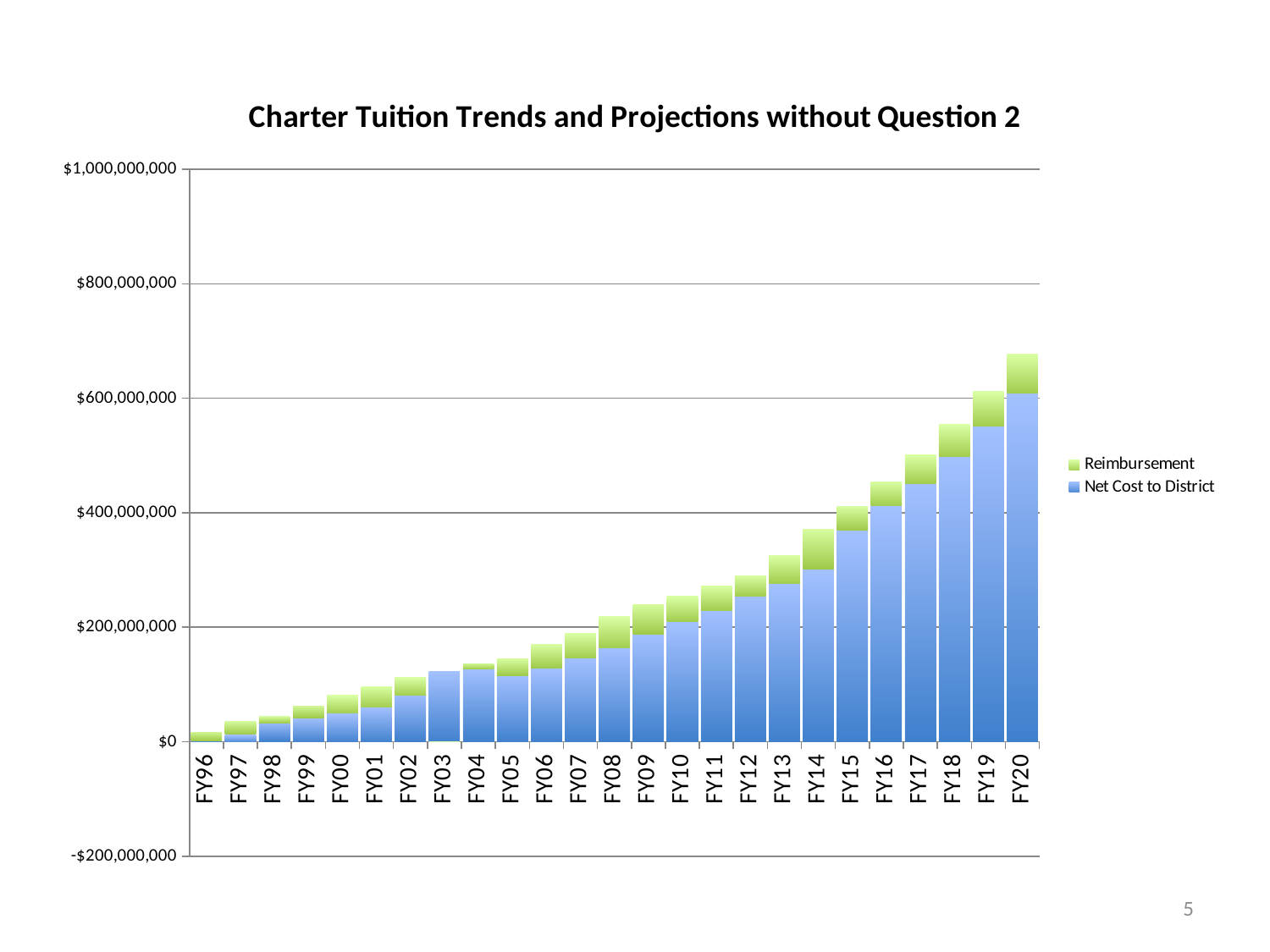
Which series is shown in green in the legend? Reimbursement Is the Net Cost to District value for FY03 greater or less than $200,000,000? less What kind of chart is shown on the slide? bar chart Is the total bar for FY14 greater or less than $400,000,000? less Is the total bar for FY20 greater or less than $600,000,000? greater Which fiscal year has the lowest total bar? FY96 What is the title of the chart? Charter Tuition Trends and Projections without Question 2 How many series does the legend list? 2 How many fiscal years are shown on the x axis? 25 Which fiscal year has the highest total bar? FY20 Do the total bar heights generally rise or fall from FY96 to FY20? rise